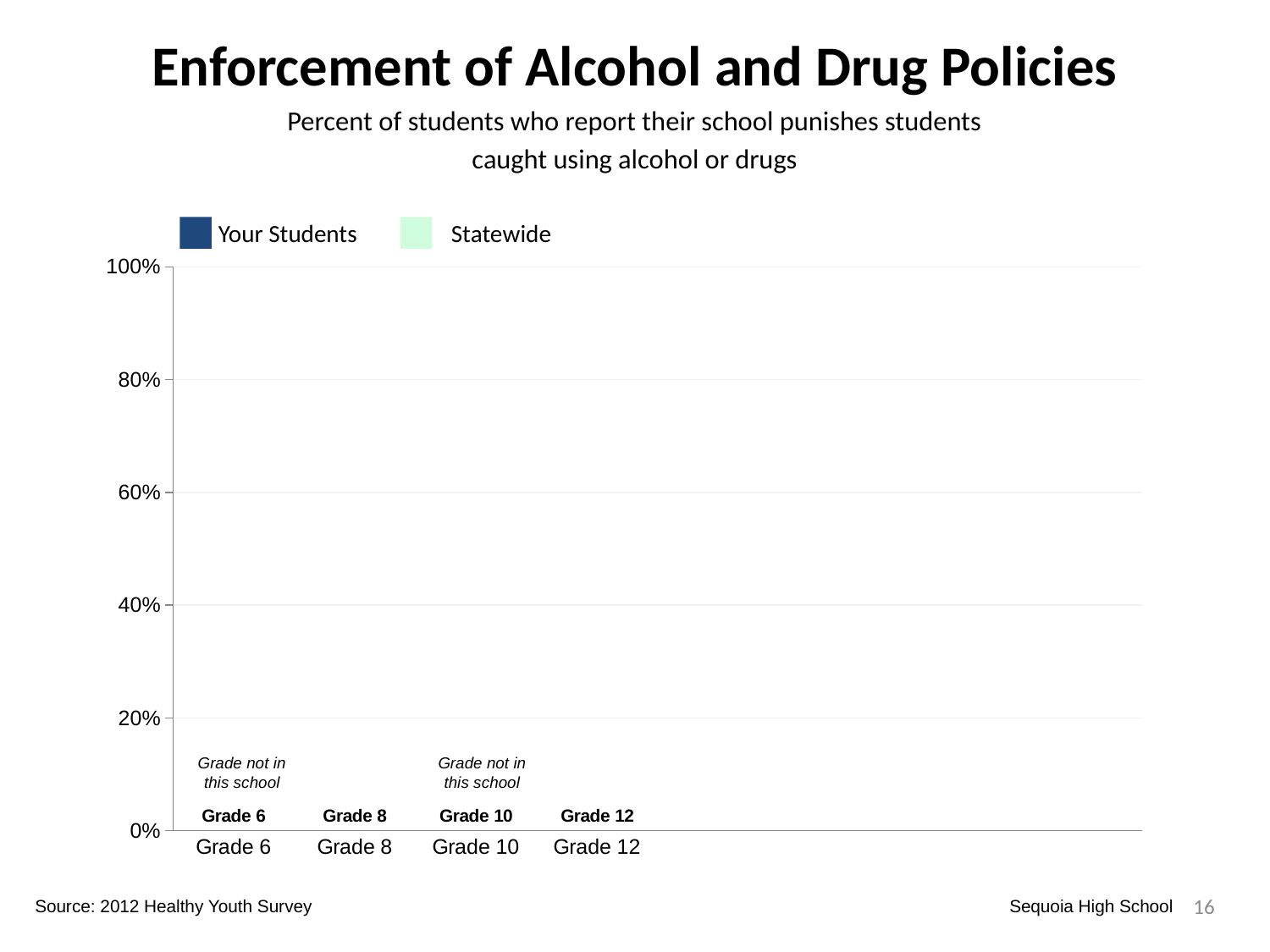
Which grade categories are marked as 'Grade not in this school' on the chart? Grade 6 and Grade 10 What is the title of the chart? Enforcement of Alcohol and Drug Policies How many grade categories are shown along the x axis of the chart? 4 How many series does the chart legend list? 2 What is the highest value shown on the chart's y axis? 100% What are the two series named in the chart legend? Your Students and Statewide